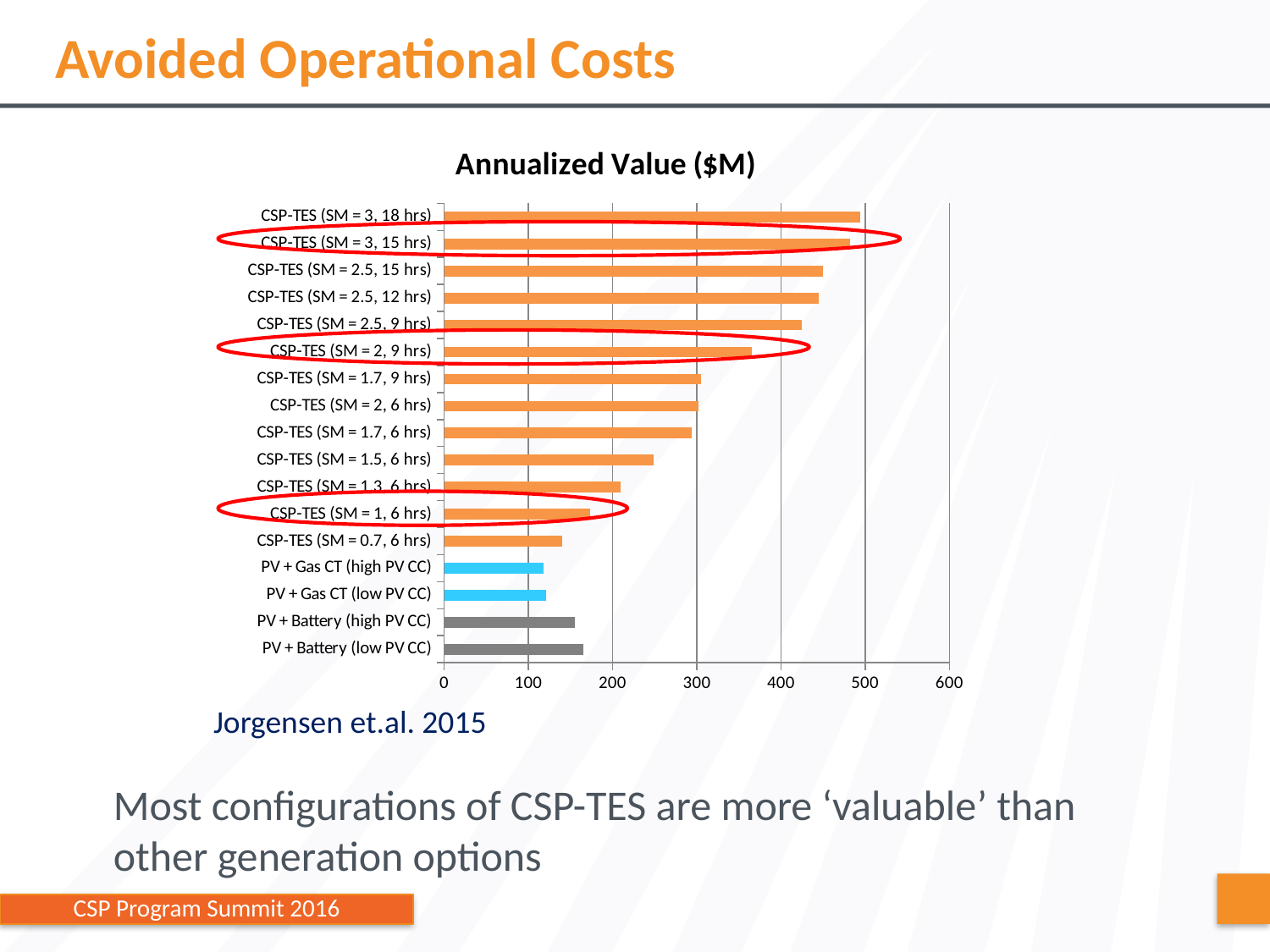
What kind of chart is shown on the slide? bar chart Is the value for PV + Gas CT (high PV CC) greater or less than 200? less Is the value for CSP-TES (SM = 1.5, 6 hrs) greater or less than 200? greater Which has the larger annualized value, CSP-TES (SM = 2.5, 9 hrs) or CSP-TES (SM = 2, 9 hrs)? CSP-TES (SM = 2.5, 9 hrs) Is the value for CSP-TES (SM = 3, 18 hrs) greater or less than 400? greater How many bars on the chart are circled in red? 3 What is the title of the chart? Annualized Value ($M) Which has the larger annualized value, CSP-TES (SM = 1.3, 6 hrs) or PV + Battery (low PV CC)? CSP-TES (SM = 1.3, 6 hrs) How many categories (bars) does the chart show? 17 Which category has the highest annualized value? CSP-TES (SM = 3, 18 hrs)